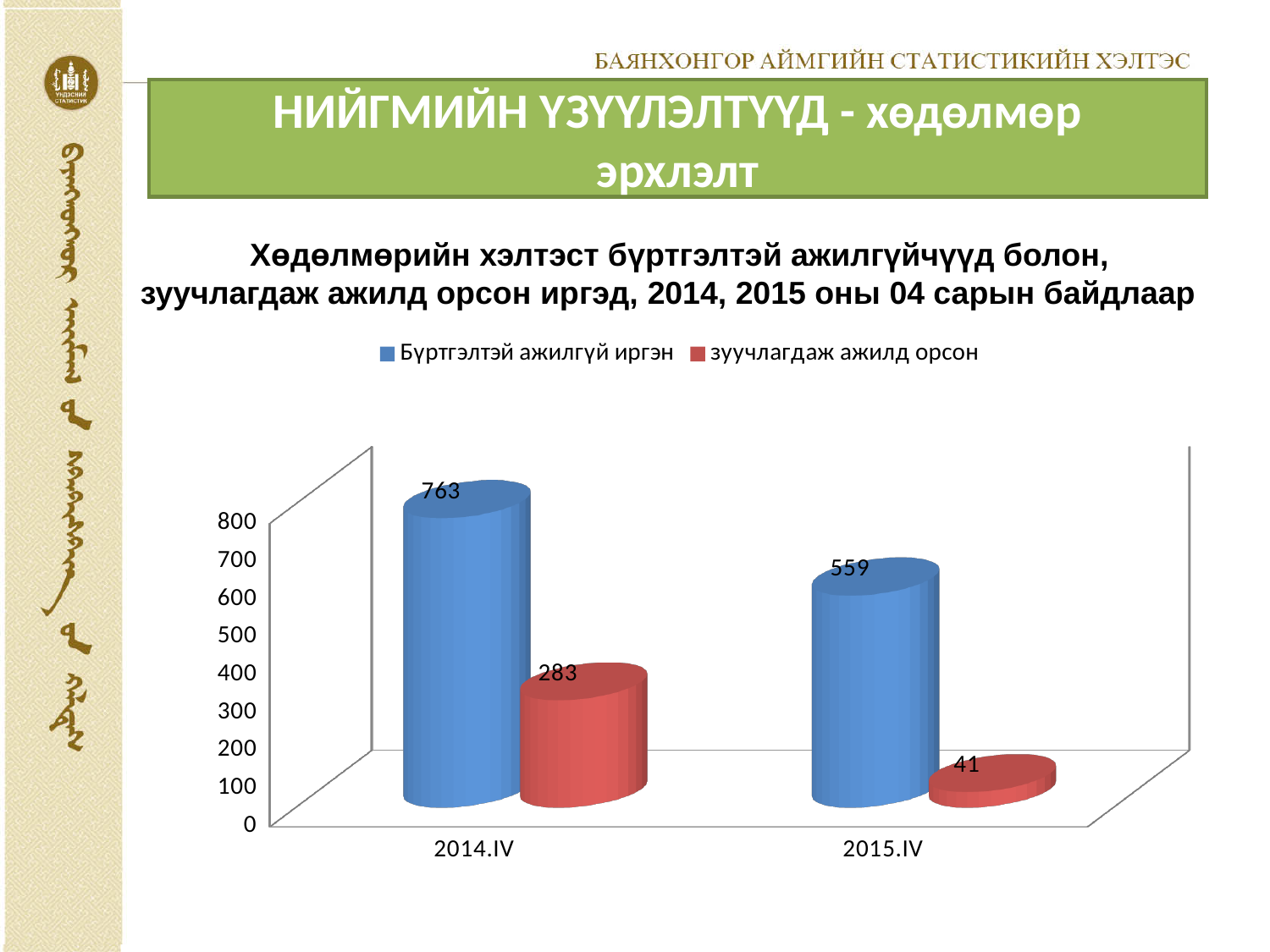
What is the value for "зуучлагдаж ажилд орсон" in 2015.IV? 41 What is the value for "Бүртгэлтэй ажилгүй иргэн" in 2015.IV? 559 Does the value for "зуучлагдаж ажилд орсон" rise or fall from 2014.IV to 2015.IV? Fall How many series does the legend list? 2 Which period has the lowest value for "зуучлагдаж ажилд орсон"? 2015.IV Is the value for "Бүртгэлтэй ажилгүй иргэн" in 2015.IV greater or less than 500? greater What is the difference between the "Бүртгэлтэй ажилгүй иргэн" values for 2014.IV and 2015.IV? 204 What is the value for "зуучлагдаж ажилд орсон" in 2014.IV? 283 What kind of chart is shown on the slide? Bar chart What is the difference between the "зуучлагдаж ажилд орсон" values for 2014.IV and 2015.IV? 242 What is the value for "Бүртгэлтэй ажилгүй иргэн" in 2014.IV? 763 Which period has the higher value for "Бүртгэлтэй ажилгүй иргэн"? 2014.IV